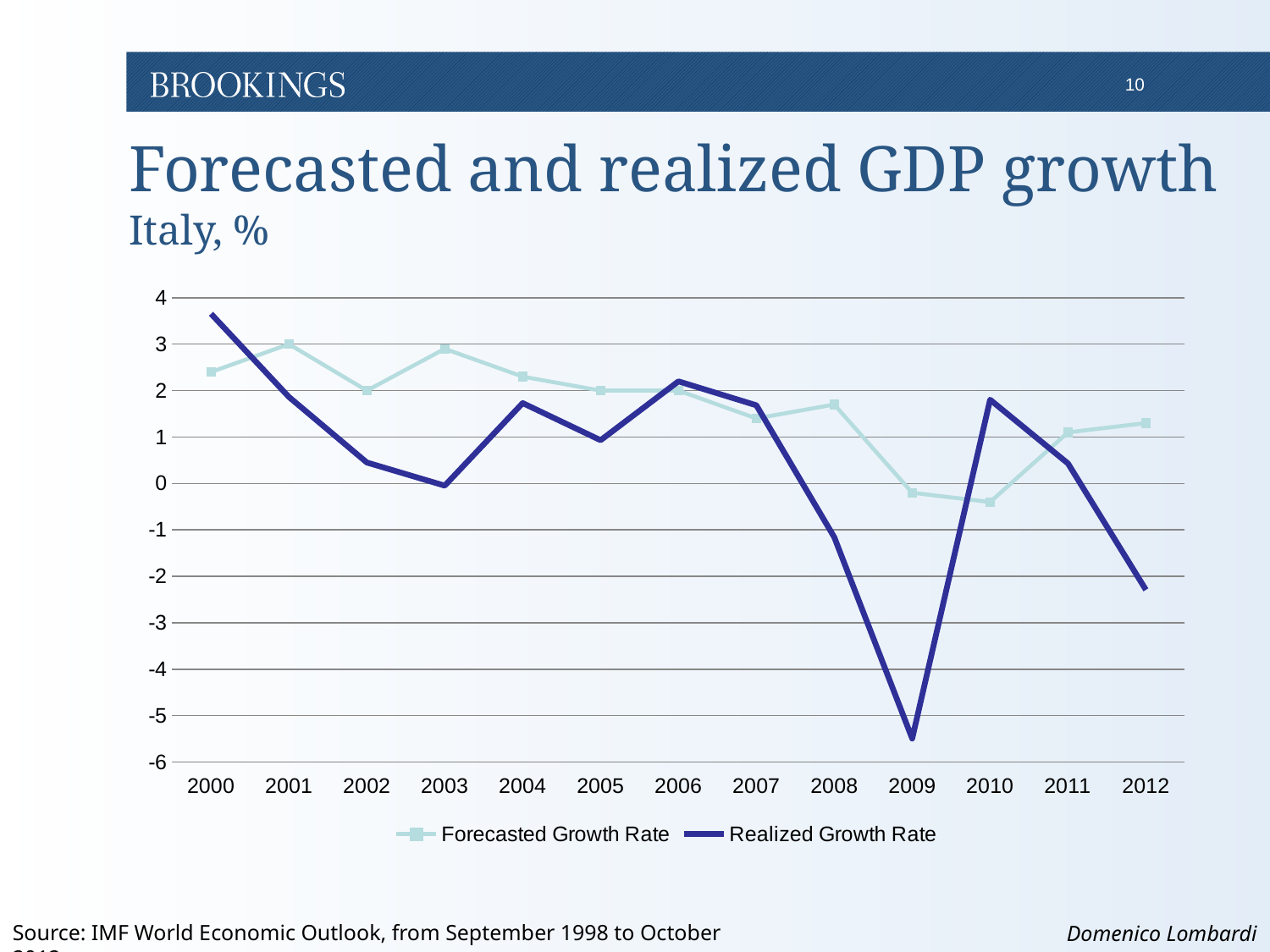
In 2009, which is larger: the Forecasted Growth Rate or the Realized Growth Rate? Forecasted Growth Rate Which country does the chart's subtitle say the data is for? Italy Is the Realized Growth Rate for 2012 greater or less than -2? less Is the Realized Growth Rate for 2009 greater or less than -5? less What kind of chart is shown on the slide? Line chart In which year is the Realized Growth Rate at its highest? 2000 Is the Forecasted Growth Rate for 2003 greater or less than 2? greater How many series does the legend list? 2 Does the Realized Growth Rate rise or fall from 2010 to 2012? Fall How many years are plotted along the x axis? 13 In which year is the Realized Growth Rate at its lowest? 2009